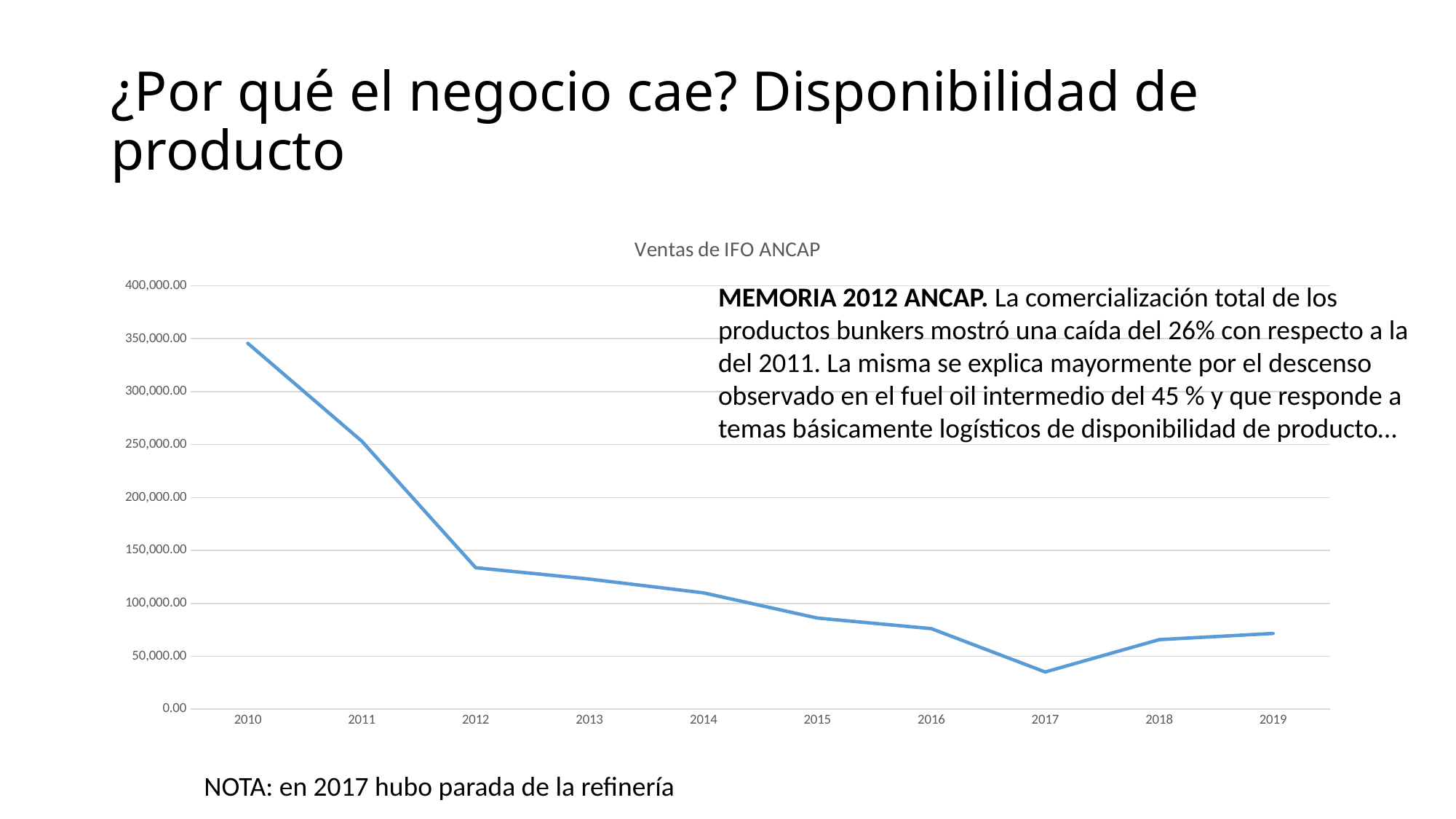
Is the value for 2012 greater or less than 150,000.00? less How many years are plotted on the x axis of the chart? 10 Is the value for 2017 greater or less than 50,000.00? less Which year has the larger value, 2017 or 2019? 2019 Which year has the lowest value in the chart? 2017 Do the values generally rise or fall from 2010 to 2017? fall Which year has the highest value in the chart? 2010 What is the title of the chart? Ventas de IFO ANCAP Is the value for 2014 greater or less than 100,000.00? greater Which year has the larger value, 2011 or 2013? 2011 What kind of chart is shown on the slide? line chart